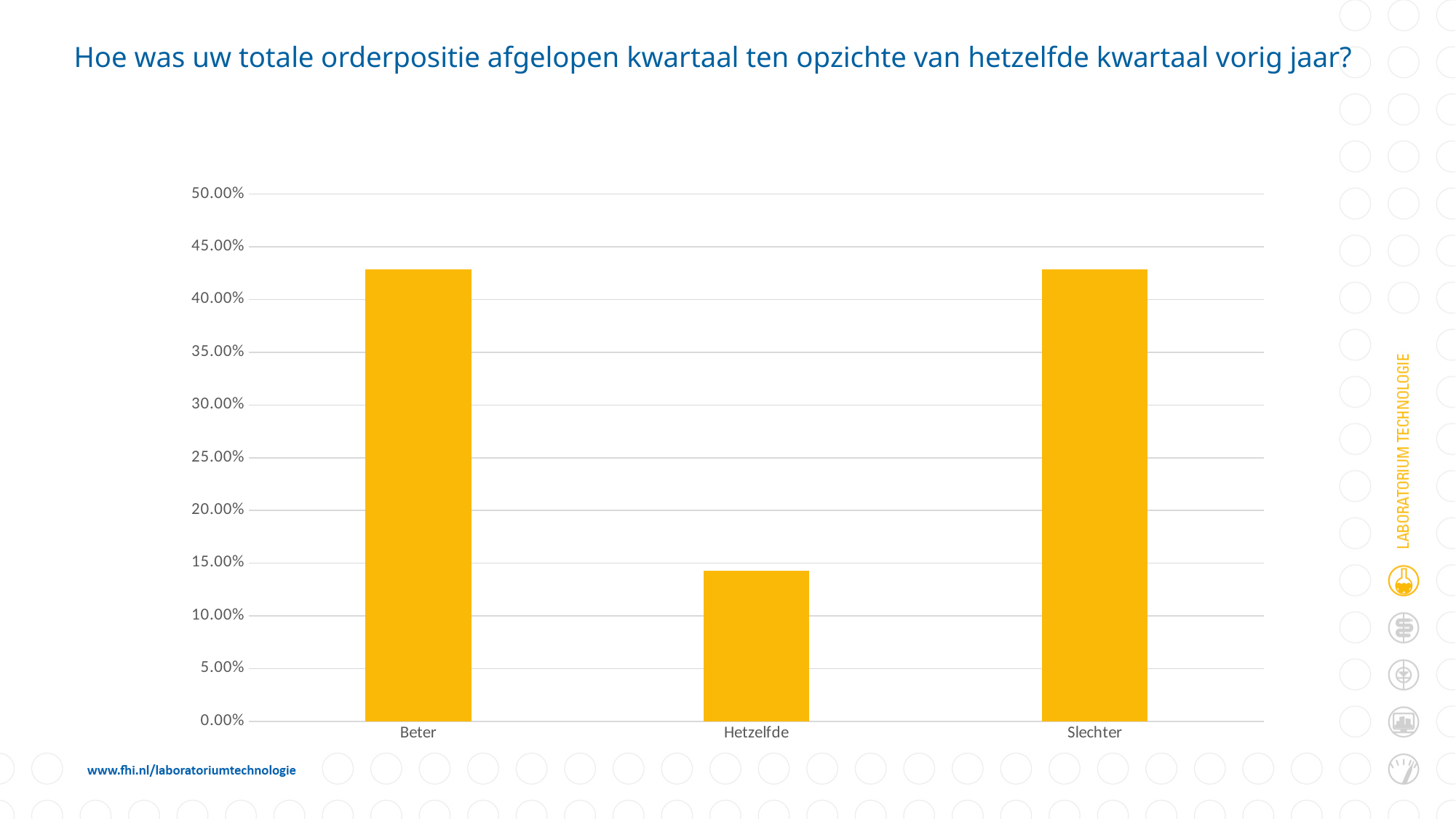
Is the value for Hetzelfde greater or less than 15.00%? less Is the value for Slechter greater or less than 45.00%? less Is the value for Hetzelfde greater or less than 10.00%? greater What is the highest value shown on the y axis of the chart? 50.00% Which is larger, the value for Beter or the value for Hetzelfde? Beter How many categories are shown on the x axis of the chart? 3 What is the title of the chart on the slide? Hoe was uw totale orderpositie afgelopen kwartaal ten opzichte van hetzelfde kwartaal vorig jaar? Which category has the lowest value in the chart? Hetzelfde Which is larger, the value for Slechter or the value for Hetzelfde? Slechter What kind of chart is shown on the slide? bar chart